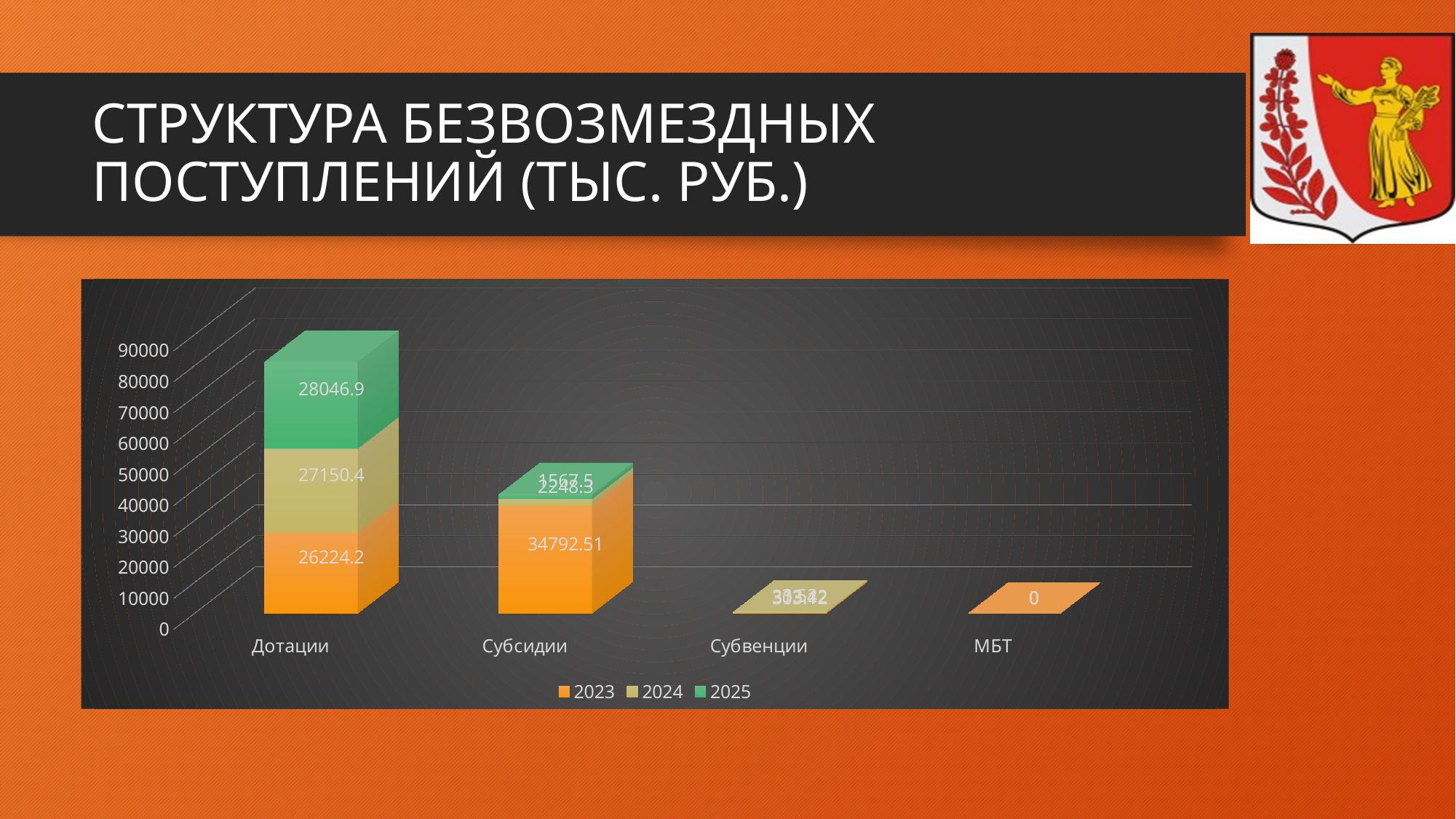
How many categories are shown on the x axis? 4 What is the difference between the 2025 and 2023 values for Дотации? 1822.7 What is the value for МБТ in 2023? 0 Which is larger in 2023: Дотации or Субсидии? Субсидии Which category has the tallest stacked bar? Дотации What is the value for Субсидии in 2023? 34792.51 How many series does the legend list? 3 Which category has the lowest stacked bar? МБТ What is the total of the stacked bar for Дотации? 81421.5 What is the value for Дотации in 2025? 28046.9 What is the value for Дотации in 2023? 26224.2 Do the values for Дотации rise or fall from 2023 to 2025? rise